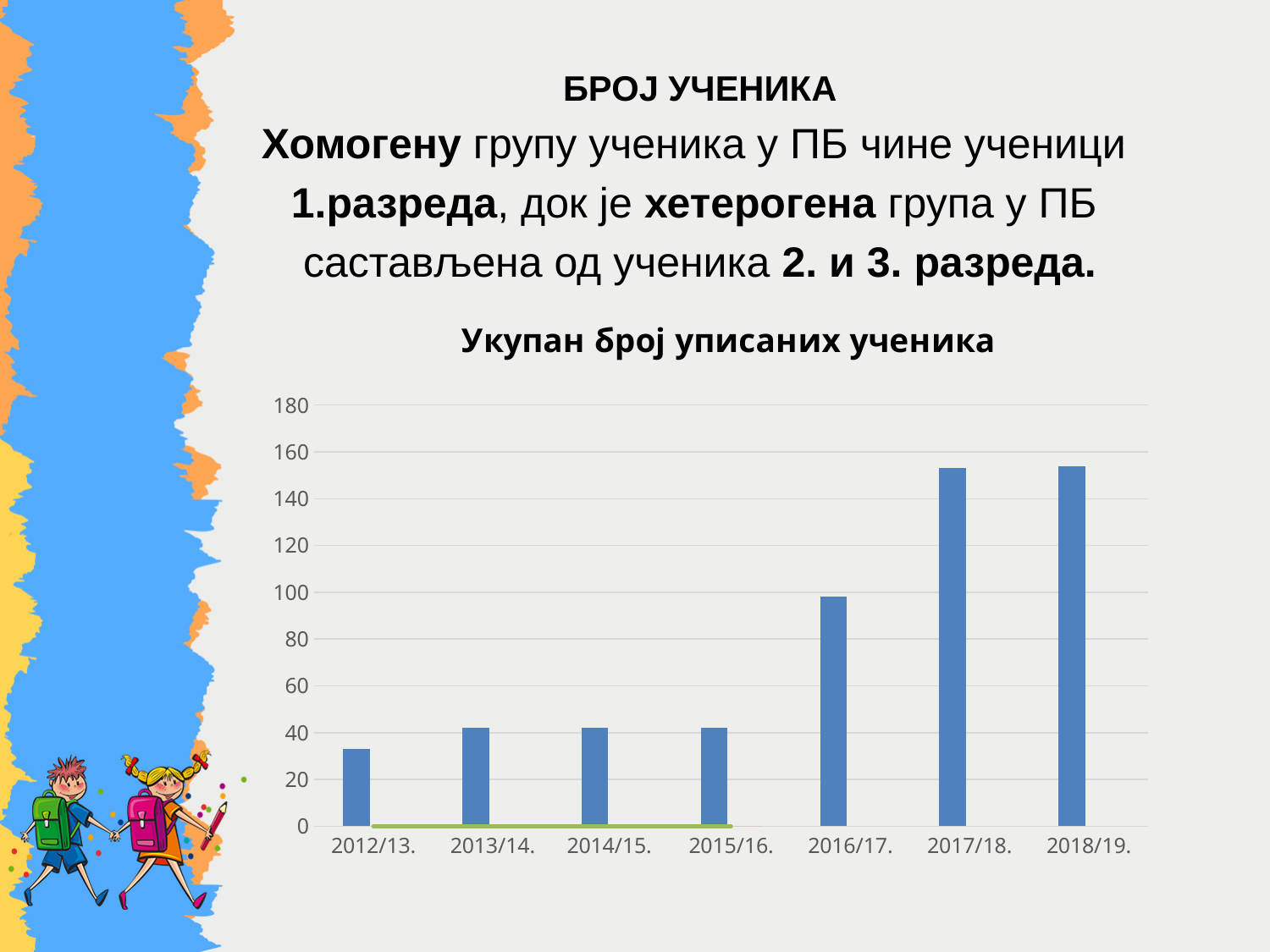
What is the title of the chart? Укупан број уписаних ученика Is the value for 2018/19. greater or less than 160? less Is the value for 2017/18. greater or less than 140? greater What is the highest value shown on the vertical axis of the chart? 180 Which school year has the lowest number of enrolled students? 2012/13. Which is larger, the value for 2015/16. or the value for 2016/17.? 2016/17. What kind of chart is shown on the slide? bar chart Is the value for 2016/17. greater or less than 80? greater How many school years are shown on the x axis of the chart? 7 Do the values generally rise or fall from 2012/13. to 2018/19.? rise